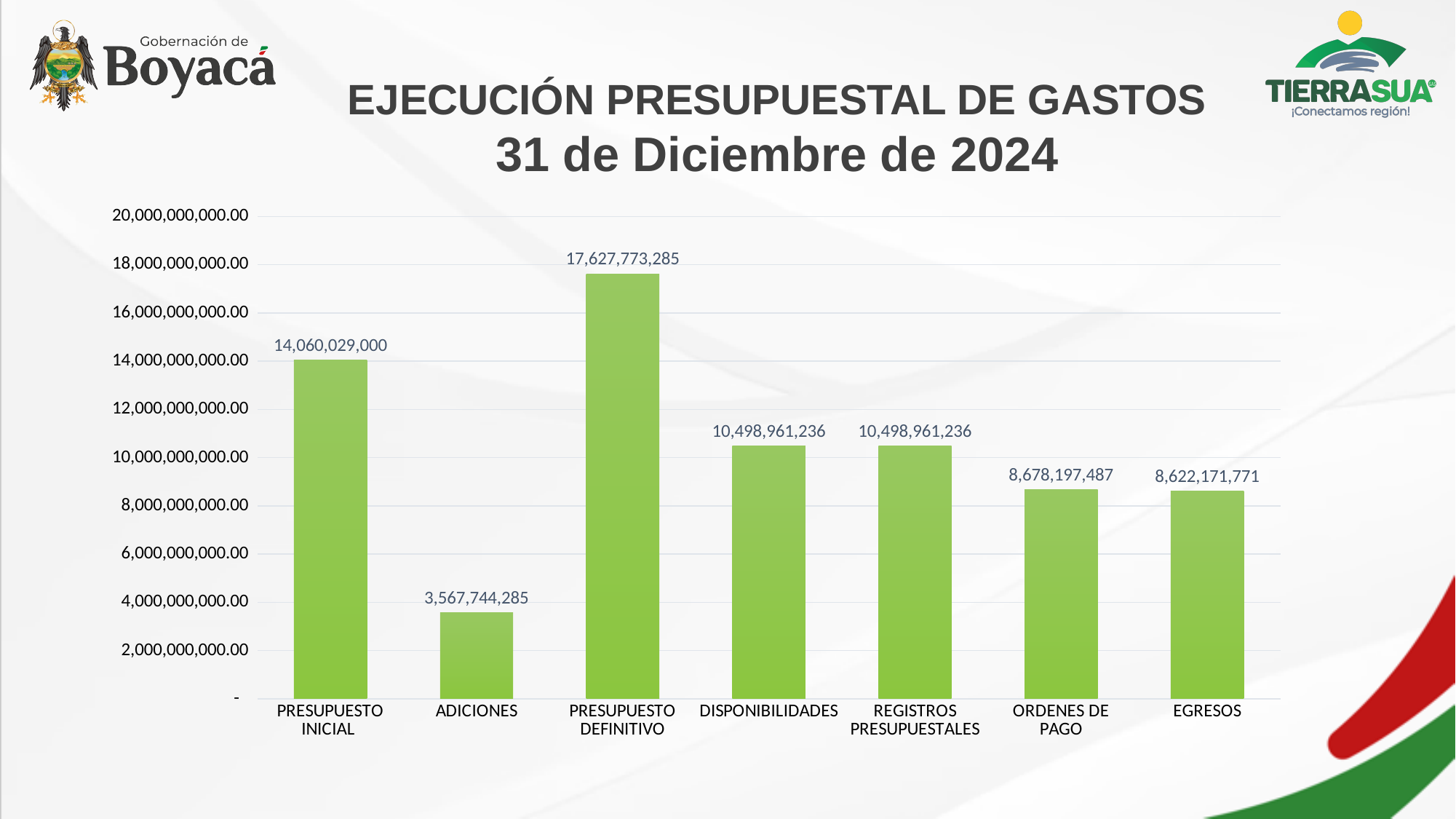
How many categories are shown on the x axis? 7 Which category has the highest value? PRESUPUESTO DEFINITIVO What is the value for PRESUPUESTO DEFINITIVO? 17,627,773,285 What type of chart is shown on the slide? Bar chart Which is larger, ORDENES DE PAGO or EGRESOS? ORDENES DE PAGO Which category has the lowest value? ADICIONES What is the value for ADICIONES? 3,567,744,285 What is the difference between PRESUPUESTO DEFINITIVO and PRESUPUESTO INICIAL? 3,567,744,285 What is the value for EGRESOS? 8,622,171,771 What is the difference between ORDENES DE PAGO and EGRESOS? 56,025,716 What is the value for REGISTROS PRESUPUESTALES? 10,498,961,236 What is the title of the chart? EJECUCIÓN PRESUPUESTAL DE GASTOS 31 de Diciembre de 2024